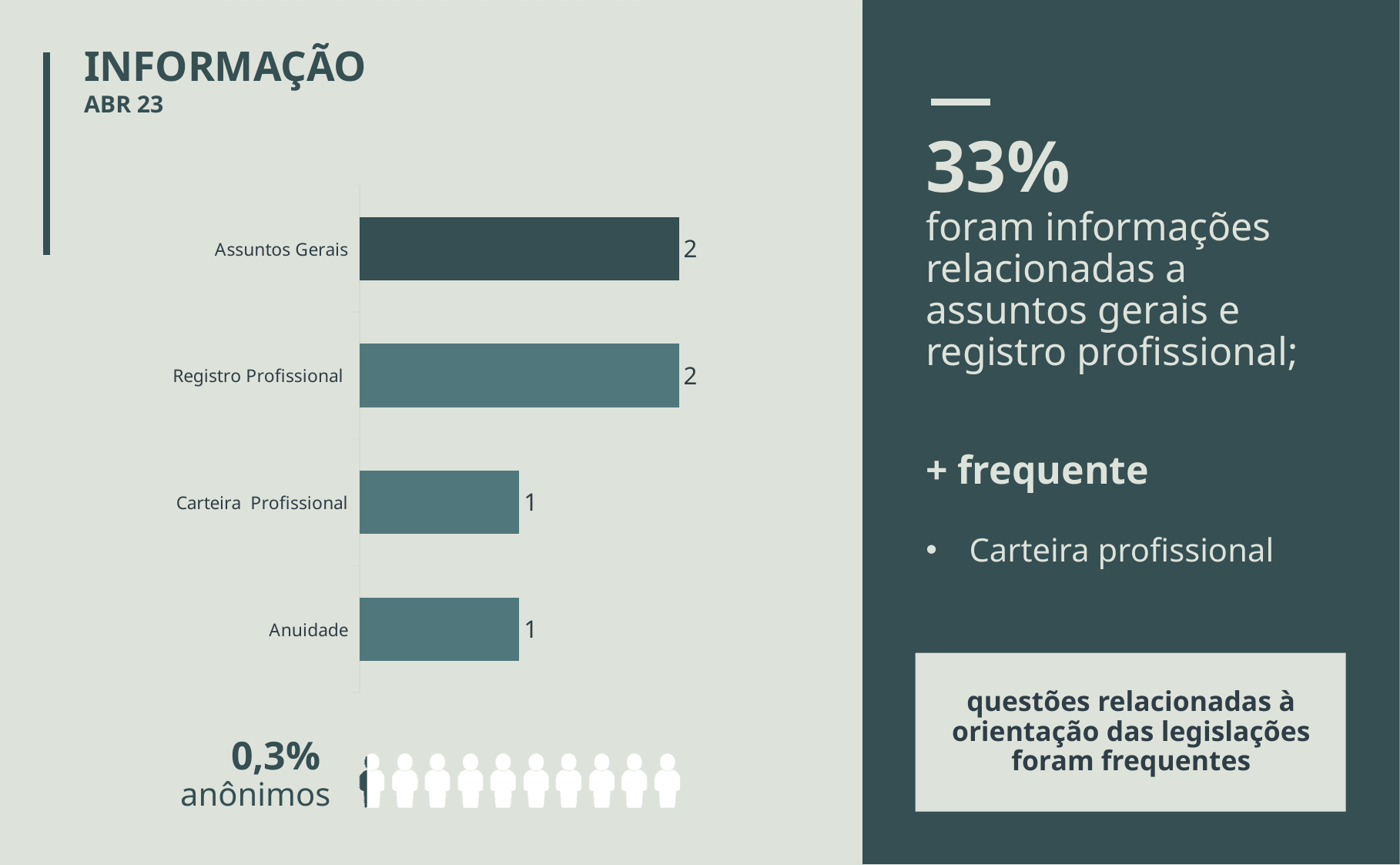
How many categories are shown in the chart? 4 Which is larger, the value for Assuntos Gerais or the value for Anuidade? Assuntos Gerais Which category's bar is drawn in a darker colour than the other bars? Assuntos Gerais What kind of chart is shown on the slide? bar chart What is the value for Carteira Profissional? 1 What is the value for Anuidade? 1 What is the difference between the values for Registro Profissional and Carteira Profissional? 1 What is the value for Registro Profissional? 2 What is the value for Assuntos Gerais? 2 What is the difference between the values for Assuntos Gerais and Anuidade? 1 Which is larger, the value for Carteira Profissional or the value for Registro Profissional? Registro Profissional What is the sum of the values of all four bars in the chart? 6